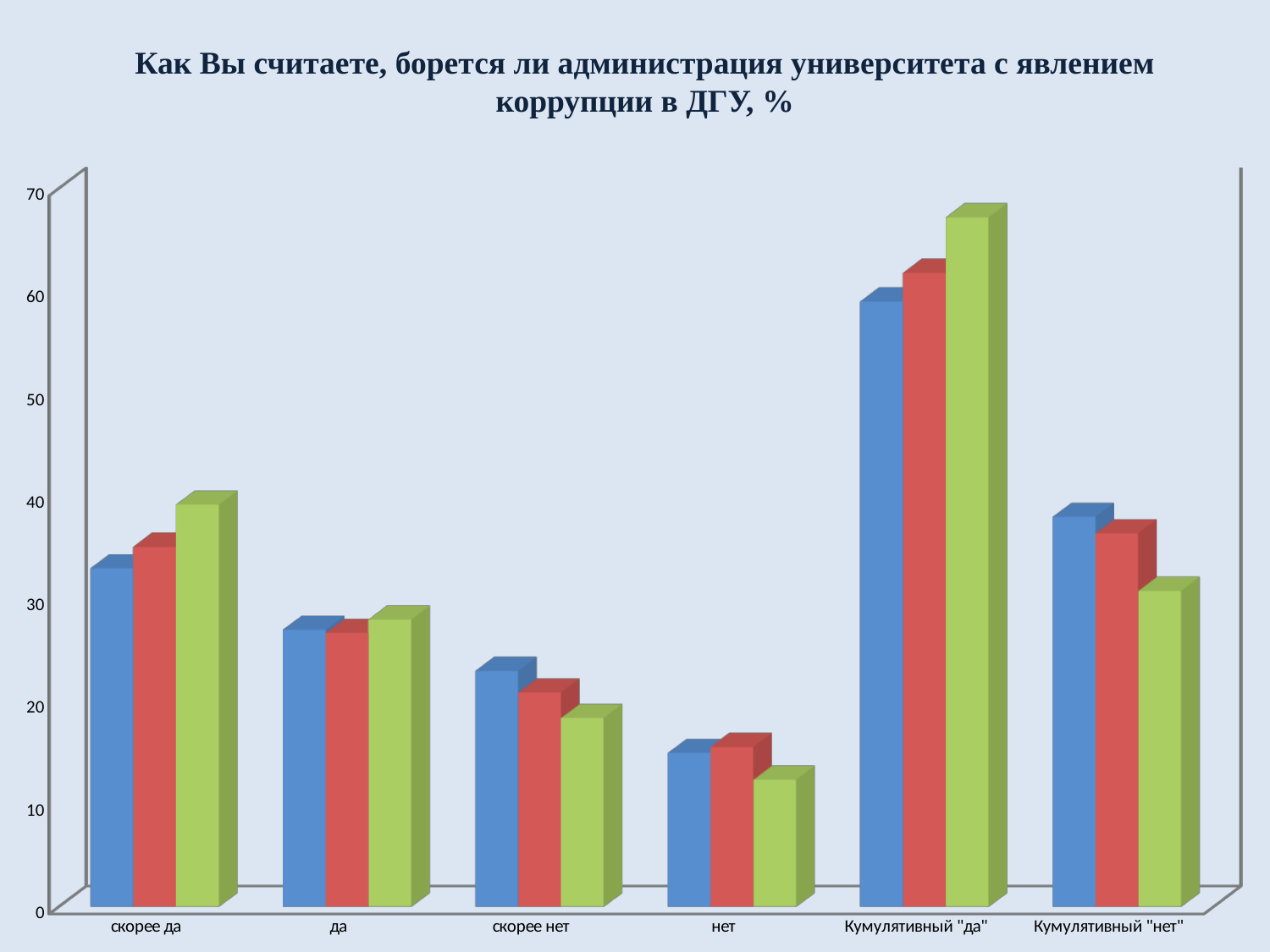
Which is larger: the green bar for "скорее да" or the green bar for "да"? скорее да How many categories are shown along the x axis? 6 Which category has the tallest bars overall? Кумулятивный "да" Is the value of the green bar for "Кумулятивный "да"" greater or less than 60? greater Is the value of the blue bar for "Кумулятивный "нет"" greater or less than 40? less What is the title of the chart? Как Вы считаете, борется ли администрация университета с явлением коррупции в ДГУ, % What kind of chart is shown on the slide? bar chart Within the category "Кумулятивный "да"", which coloured bar is the tallest? green Is the value of the red bar for "нет" greater or less than 20? less Which category has the shortest bars overall? нет